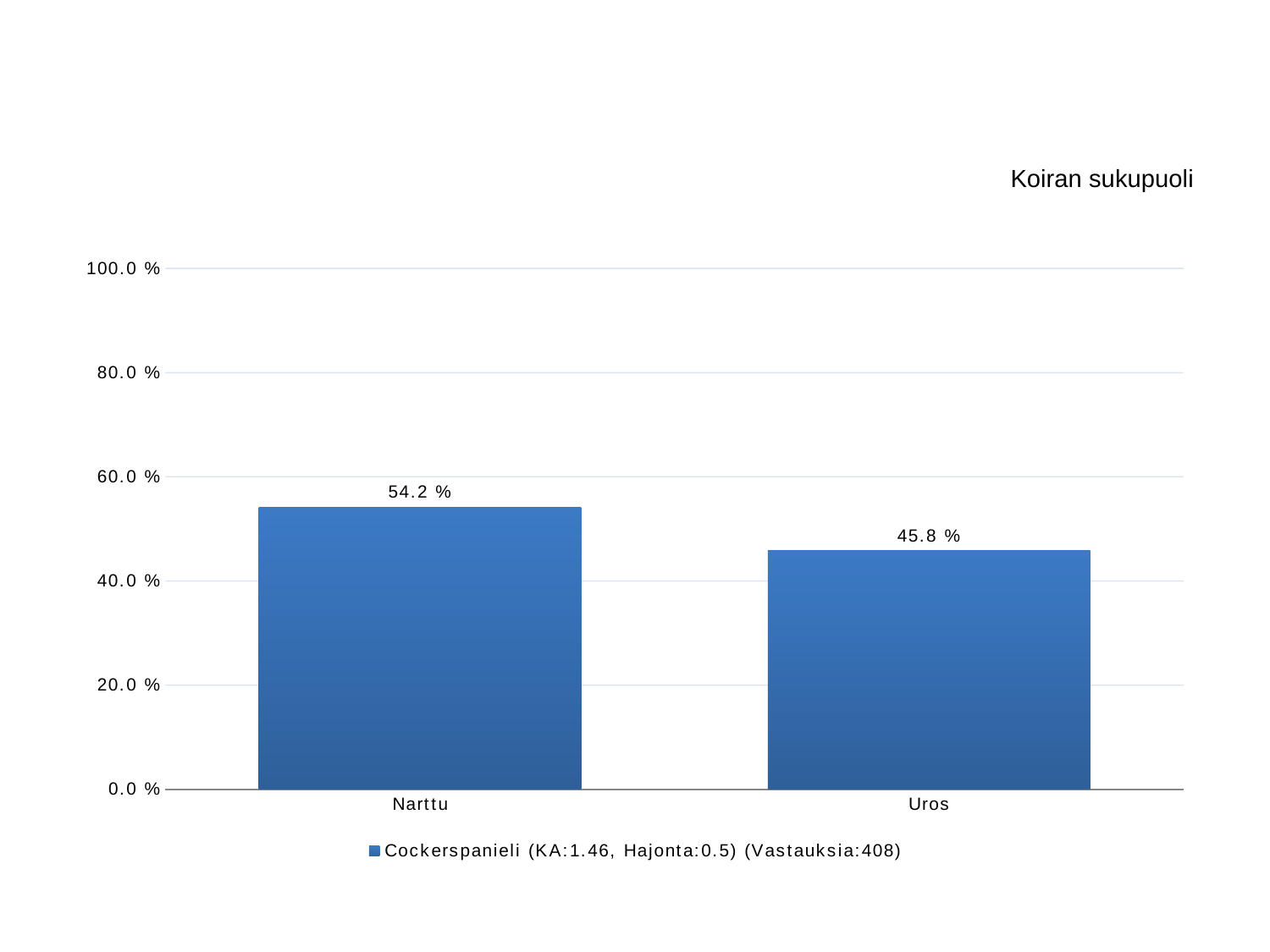
What kind of chart is shown on the slide? bar chart What is the title of the chart? Koiran sukupuoli How many series does the legend list? 1 Is the value for Narttu greater or less than 40.0 %? greater How many categories are shown on the x axis? 2 Which is larger, the value for Narttu or the value for Uros? Narttu What is the value for Uros? 45.8 % Which category has the highest value? Narttu What is the value for Narttu? 54.2 % What is the difference between the values for Narttu and Uros? 8.4 % Is the value for Uros greater or less than 60.0 %? less Which category has the lowest value? Uros